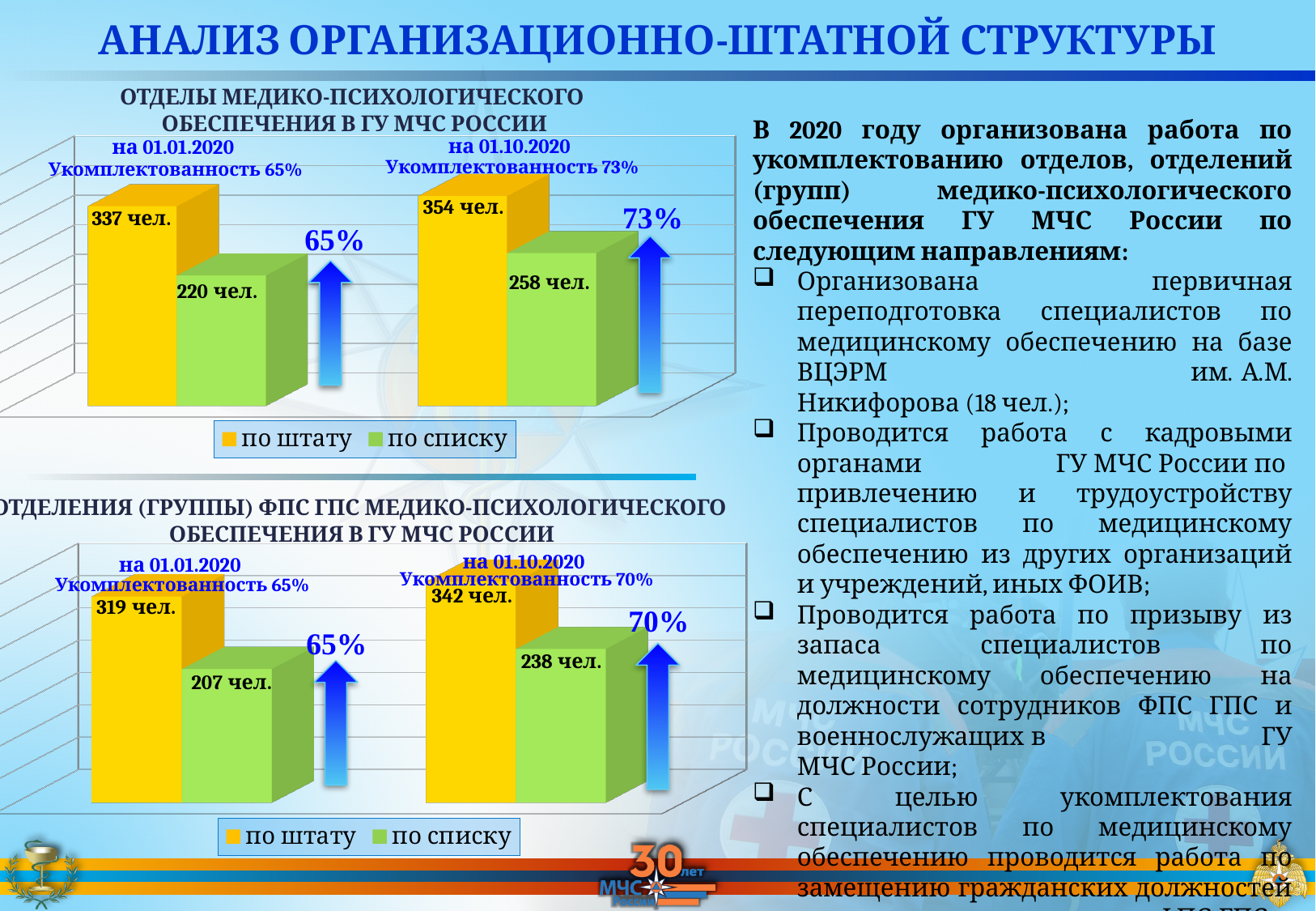
In the bottom chart, which colour represents the 'по штату' series? yellow In the bottom chart, what is the value for 'по списку' on 01.01.2020? 207 чел. In the bottom chart (Отделения (группы) ФПС ГПС), what is the value for 'по штату' on 01.10.2020? 342 чел. In the top chart (Отделы медико-психологического обеспечения), what is the value for 'по штату' on 01.01.2020? 337 чел. In the top chart, what is the difference between 'по штату' and 'по списку' on 01.01.2020? 117 чел. In the bottom chart, what is the difference between 'по штату' and 'по списку' on 01.10.2020? 104 чел. How many series does the legend of the top chart list? 2 In the top chart, which is larger: 'по списку' on 01.01.2020 or 'по списку' on 01.10.2020? по списку on 01.10.2020 In the bottom chart, does the 'по списку' value rise or fall from 01.01.2020 to 01.10.2020? rise In the top chart, what staffing percentage (укомплектованность) is shown for 01.10.2020? 73% What kind of chart is the bottom chart? bar chart In the top chart, what is the value for 'по списку' on 01.10.2020? 258 чел.